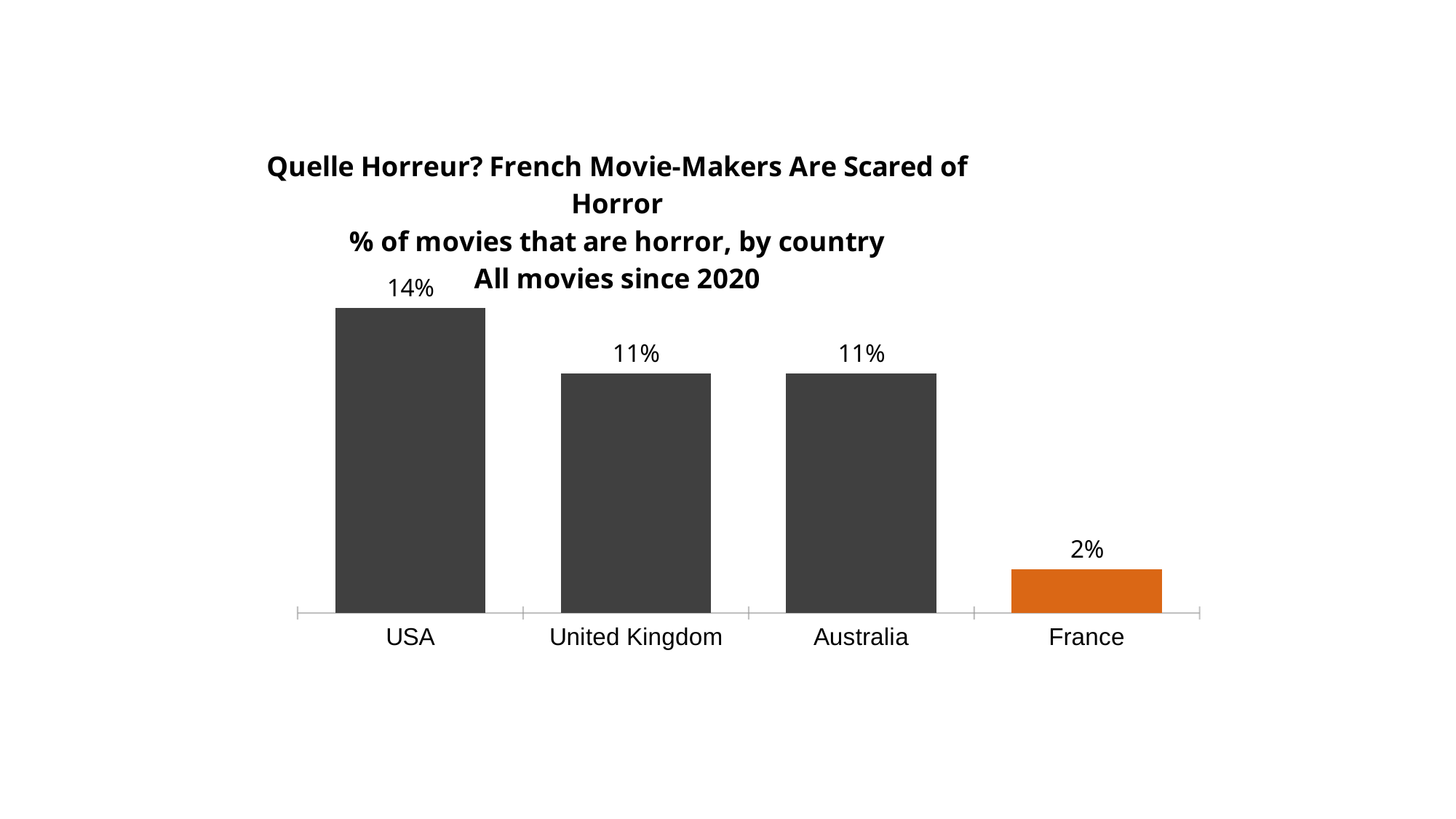
Which country has the highest share of horror movies? USA Which country has the lowest share of horror movies? France What kind of chart is this? Bar chart What percentage of movies are horror in the United Kingdom? 11% How many countries are shown in the chart? 4 What is the difference between the USA and France values? 12% Which is larger, the value for Australia or the value for France? Australia What percentage of movies are horror in Australia? 11% Which country's bar is coloured orange? France What percentage of movies are horror in France? 2% What is the difference between the USA and United Kingdom values? 3% What percentage of movies are horror in the USA? 14%